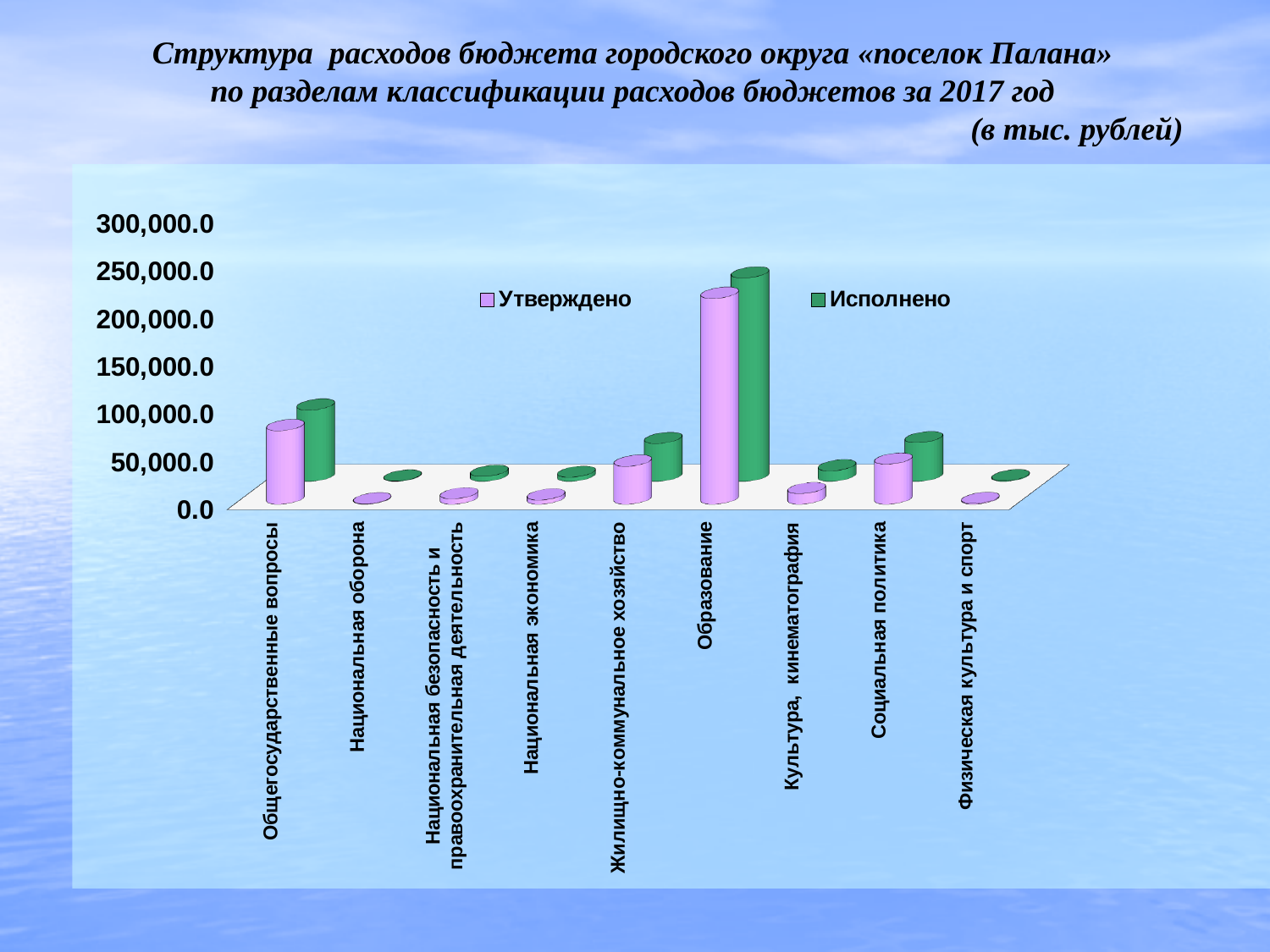
In what units are the values on the chart expressed, according to the title? тыс. рублей Is the Утверждено value for Образование greater or less than 200,000.0? greater Is the Утверждено value for Общегосударственные вопросы greater or less than 100,000.0? less What kind of chart is shown on the slide? bar chart How many expenditure categories are shown on the x axis? 9 Is the Исполнено value for Образование greater or less than 150,000.0? greater Which category has the larger Утверждено value: Образование or Общегосударственные вопросы? Образование Which category has the highest Исполнено value? Образование Which category has the highest Утверждено value? Образование How many series does the legend list? 2 What are the two series named in the legend? Утверждено and Исполнено